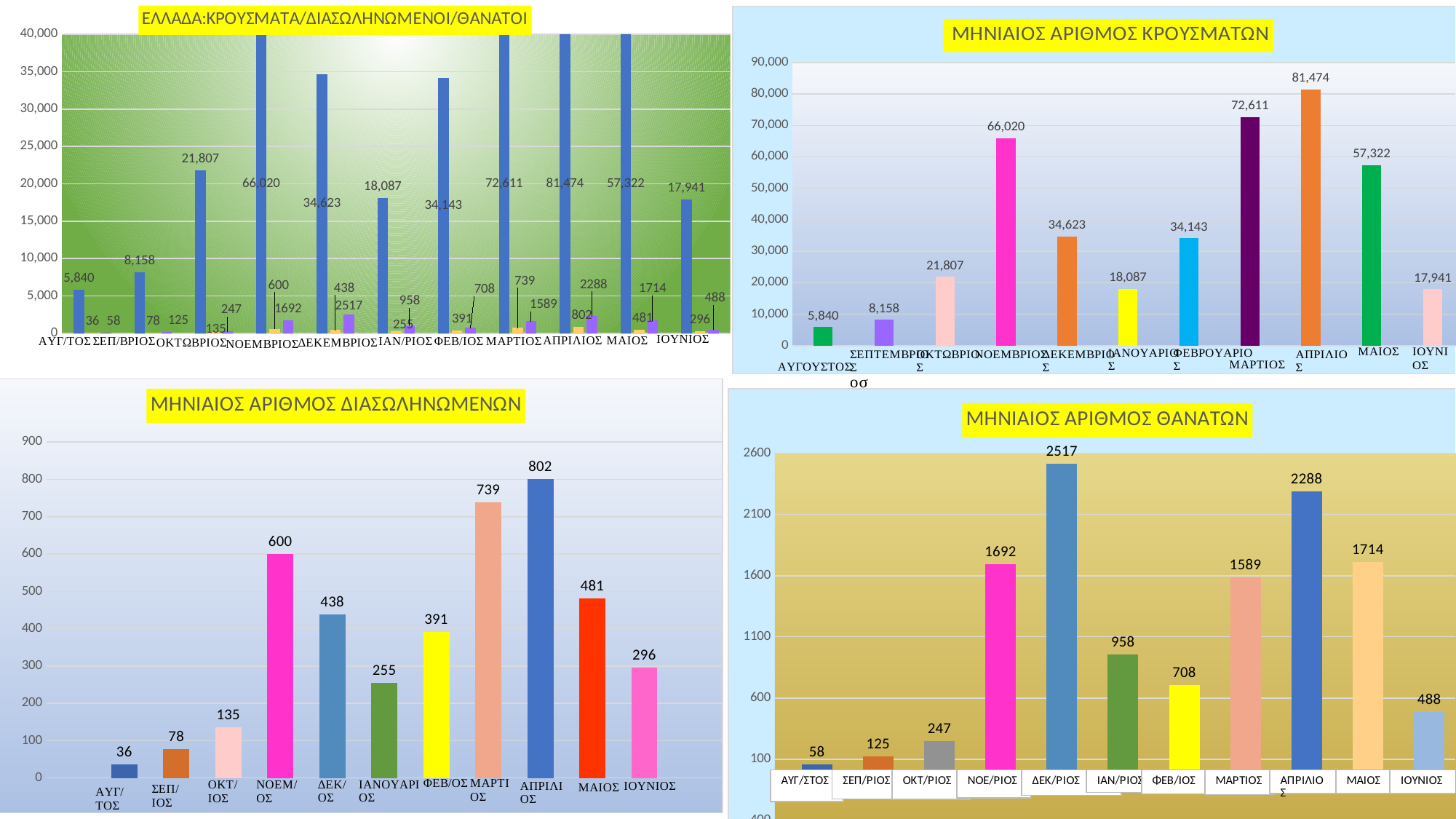
In the chart titled ΜΗΝΙΑΙΟΣ ΑΡΙΘΜΟΣ ΚΡΟΥΣΜΑΤΩΝ (top right), what is the difference between the values for ΜΑΡΤΙΟΣ and ΝΟΕΜΒΡΙΟΣ? 6,591 In the chart titled ΜΗΝΙΑΙΟΣ ΑΡΙΘΜΟΣ ΚΡΟΥΣΜΑΤΩΝ (top right), is the value for ΜΑΙΟΣ greater or less than 50,000? greater In the chart titled ΜΗΝΙΑΙΟΣ ΑΡΙΘΜΟΣ ΔΙΑΣΩΛΗΝΩΜΕΝΩΝ (bottom left), how many months are shown? 11 What kind of chart is the top-left chart titled ΕΛΛΑΔΑ:ΚΡΟΥΣΜΑΤΑ/ΔΙΑΣΩΛΗΝΩΜΕΝΟΙ/ΘΑΝΑΤΟΙ? Bar chart In the chart titled ΜΗΝΙΑΙΟΣ ΑΡΙΘΜΟΣ ΘΑΝΑΤΩΝ (bottom right), which month has the highest value? ΔΕΚ/ΡΙΟΣ In the chart titled ΜΗΝΙΑΙΟΣ ΑΡΙΘΜΟΣ ΘΑΝΑΤΩΝ (bottom right), what is the difference between the values for ΑΠΡΙΛΙΟΣ and ΜΑΙΟΣ? 574 In the chart titled ΜΗΝΙΑΙΟΣ ΑΡΙΘΜΟΣ ΘΑΝΑΤΩΝ (bottom right), what is the value for ΙΑΝ/ΡΙΟΣ? 958 In the chart titled ΜΗΝΙΑΙΟΣ ΑΡΙΘΜΟΣ ΚΡΟΥΣΜΑΤΩΝ (top right), which month has the lowest value? ΑΥΓΟΥΣΤΟΣ In the chart titled ΜΗΝΙΑΙΟΣ ΑΡΙΘΜΟΣ ΔΙΑΣΩΛΗΝΩΜΕΝΩΝ (bottom left), what is the value for ΔΕΚ/ΙΟΣ? 438 In the chart titled ΜΗΝΙΑΙΟΣ ΑΡΙΘΜΟΣ ΔΙΑΣΩΛΗΝΩΜΕΝΩΝ (bottom left), which month has the highest value? ΑΠΡΙΛΙΟΣ In the chart titled ΜΗΝΙΑΙΟΣ ΑΡΙΘΜΟΣ ΘΑΝΑΤΩΝ (bottom right), which is larger, the value for ΜΑΙΟΣ or the value for ΜΑΡΤΙΟΣ? ΜΑΙΟΣ In the chart titled ΜΗΝΙΑΙΟΣ ΑΡΙΘΜΟΣ ΚΡΟΥΣΜΑΤΩΝ (top right), what is the value for ΑΠΡΙΛΙΟΣ? 81,474